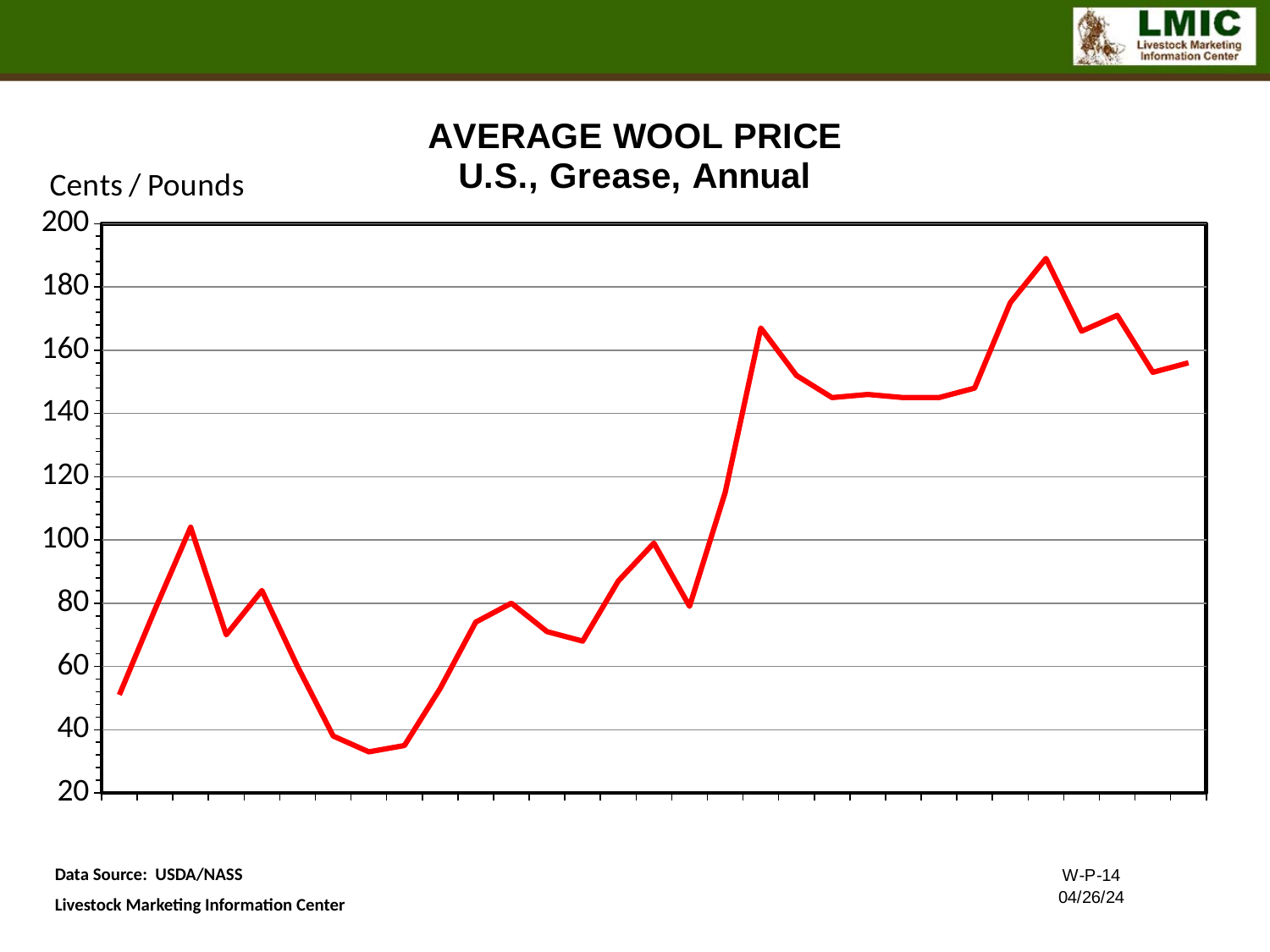
Is the highest point on the line greater or less than 180? greater Is the highest point on the line greater or less than 160? greater Is the value at the rightmost point of the line higher or lower than the value at the leftmost point? higher Is the lowest point on the line greater or less than 40? less What unit label is shown on the vertical axis of the chart? Cents / Pounds What kind of chart is shown on the slide? line chart Overall, does the line rise or fall from left to right across the chart? rise What is the title of the chart? AVERAGE WOOL PRICE U.S., Grease, Annual How many lines are plotted on the chart? 1